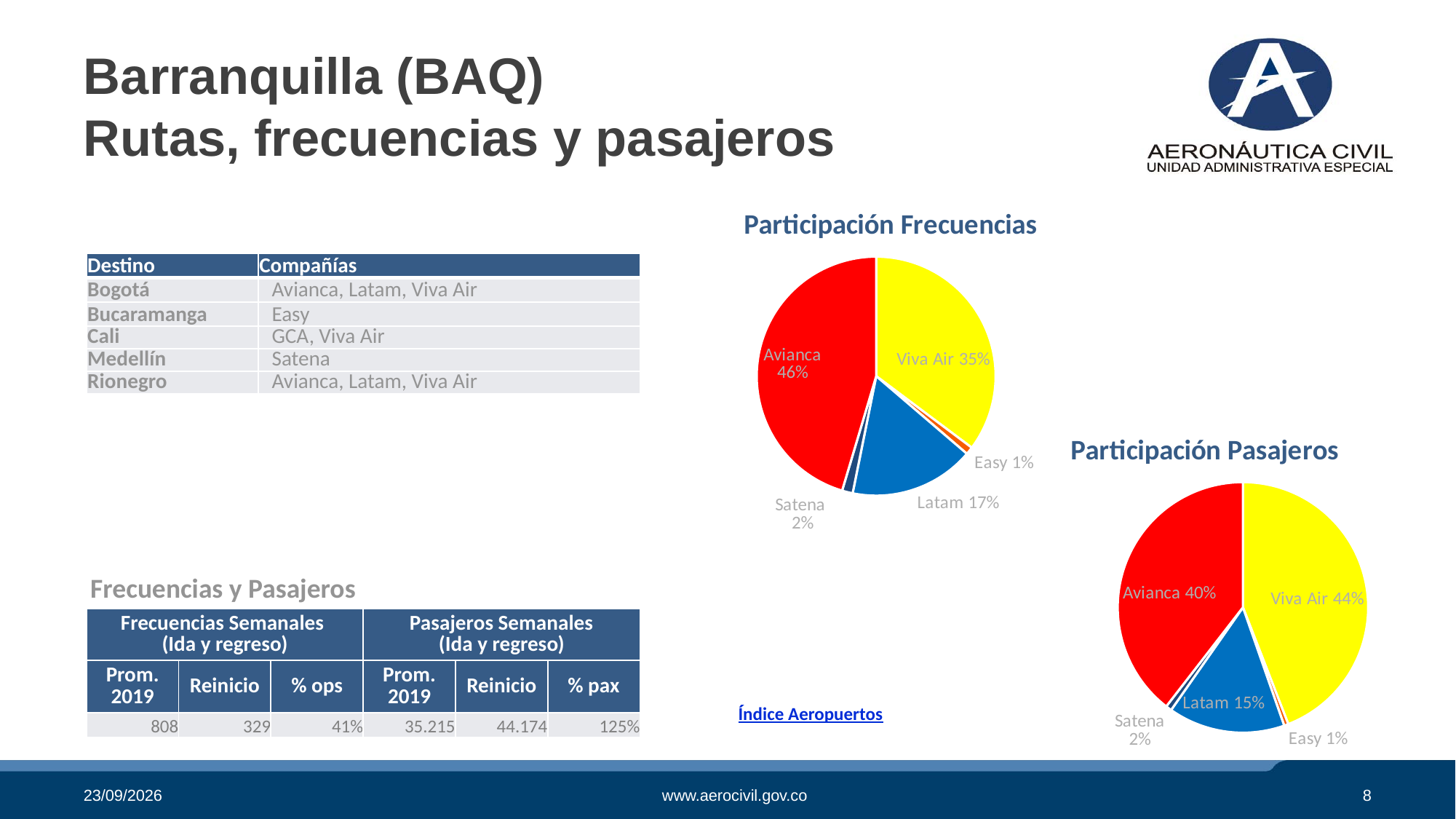
In the 'Participación Frecuencias' chart, what share does Latam have? 17% In the 'Participación Frecuencias' chart, which airline has the smallest share? Easy In the 'Participación Pasajeros' chart, what colour is the Latam slice? Blue In the 'Participación Frecuencias' chart, what is the difference between Avianca's share and Viva Air's share? 11% In the 'Participación Pasajeros' chart, which airline has the largest share? Viva Air In the 'Participación Frecuencias' chart, which airline has the largest share? Avianca In the 'Participación Pasajeros' chart, what share does Viva Air have? 44% In the 'Participación Frecuencias' chart, how many slices does the pie have? 5 What kind of chart is 'Participación Pasajeros'? Pie chart In the 'Participación Pasajeros' chart, which is larger, Avianca's share or Latam's share? Avianca In the 'Participación Frecuencias' chart, what share does Avianca have? 46% In the 'Participación Pasajeros' chart, what share does Satena have? 2%